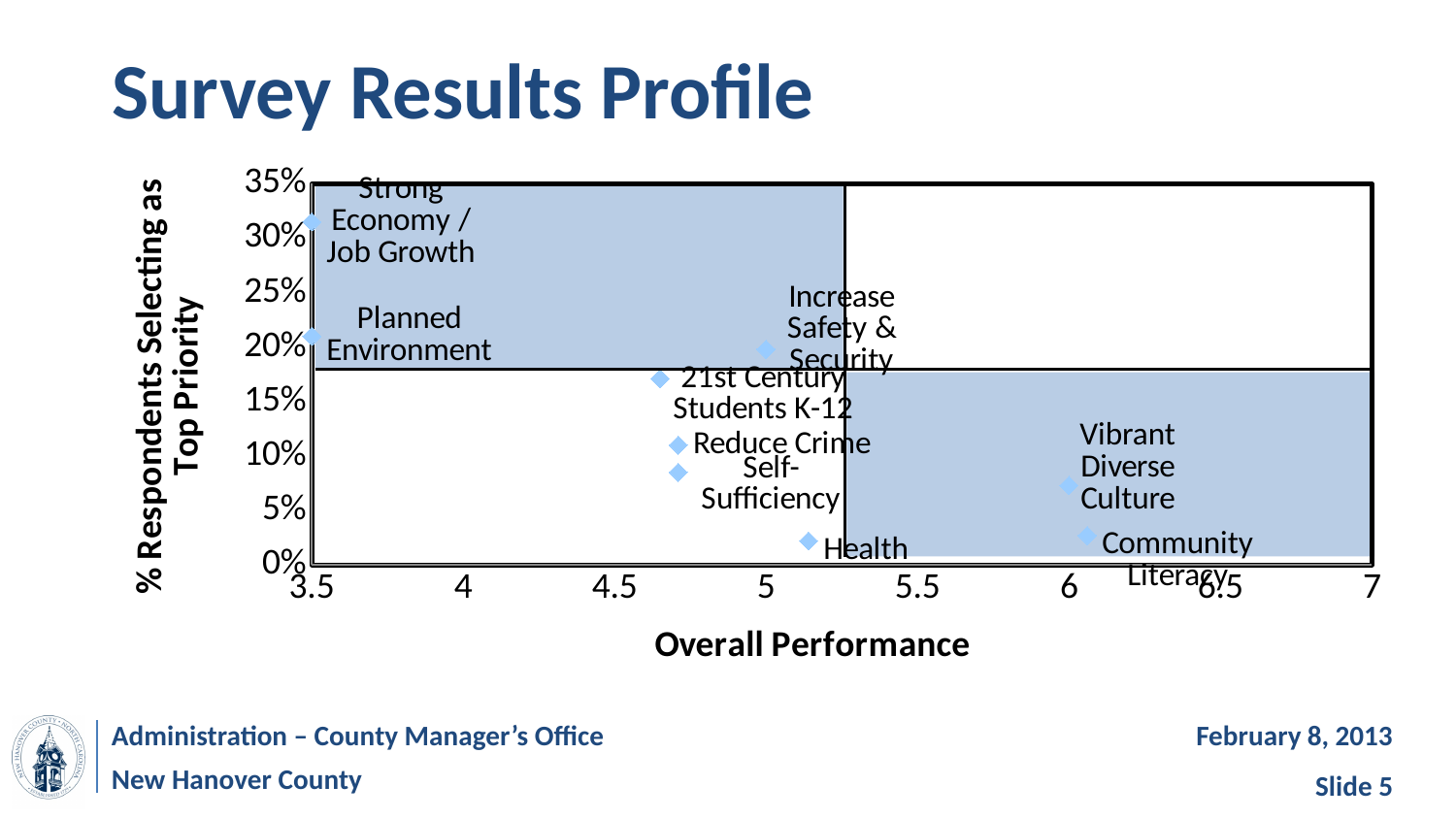
Which has a higher overall performance score, Vibrant Diverse Culture or Health? Vibrant Diverse Culture How many labeled data points are plotted on the chart? 9 Which priority has the highest percentage of respondents selecting it as top priority? Strong Economy / Job Growth Is the percentage of respondents for Strong Economy / Job Growth greater or less than 25%? greater Which has a higher percentage of respondents selecting it as top priority, Reduce Crime or Self-Sufficiency? Reduce Crime Is the percentage of respondents for Increase Safety & Security greater or less than 25%? less What is the title of the horizontal axis? Overall Performance What kind of chart is shown on the slide? scatter chart Is the percentage of respondents for Planned Environment greater or less than 15%? greater